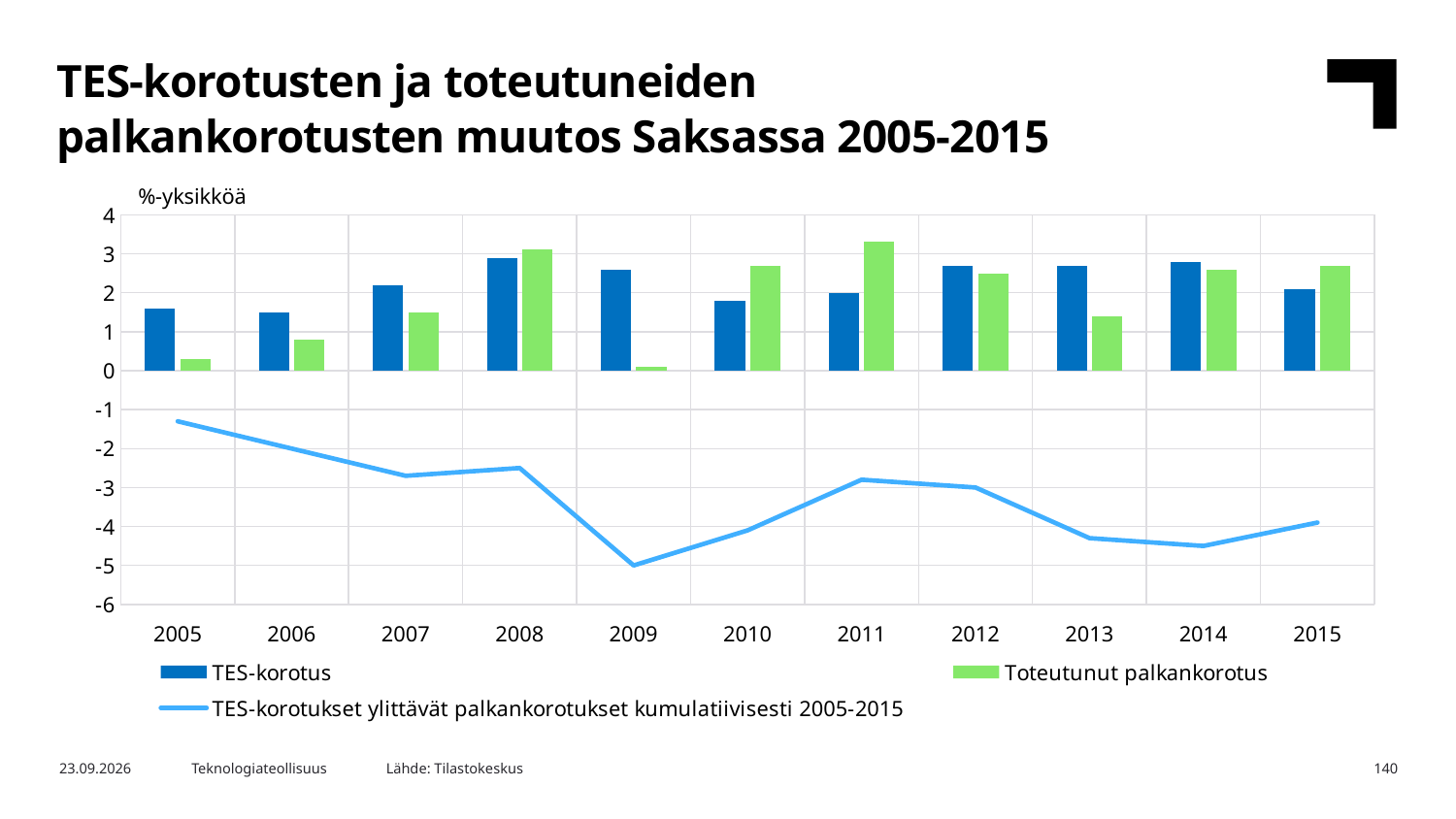
In which year is the Toteutunut palkankorotus bar lowest? 2009 What unit label is shown above the y axis of the chart? %-yksikköä In 2005, which is larger: TES-korotus or Toteutunut palkankorotus? TES-korotus In which year is the cumulative line at its highest point? 2005 Is the TES-korotus value for 2008 greater or less than 2? greater In 2011, which is larger: TES-korotus or Toteutunut palkankorotus? Toteutunut palkankorotus Is the Toteutunut palkankorotus value for 2009 greater or less than 1? less How many series does the chart legend list? 3 Does the cumulative line rise or fall from 2005 to 2009? fall What kind of chart is shown on the slide? Combined bar and line chart In which year does the line 'TES-korotukset ylittävät palkankorotukset kumulatiivisesti 2005-2015' reach its lowest point? 2009 How many years are shown on the x axis of the chart? 11